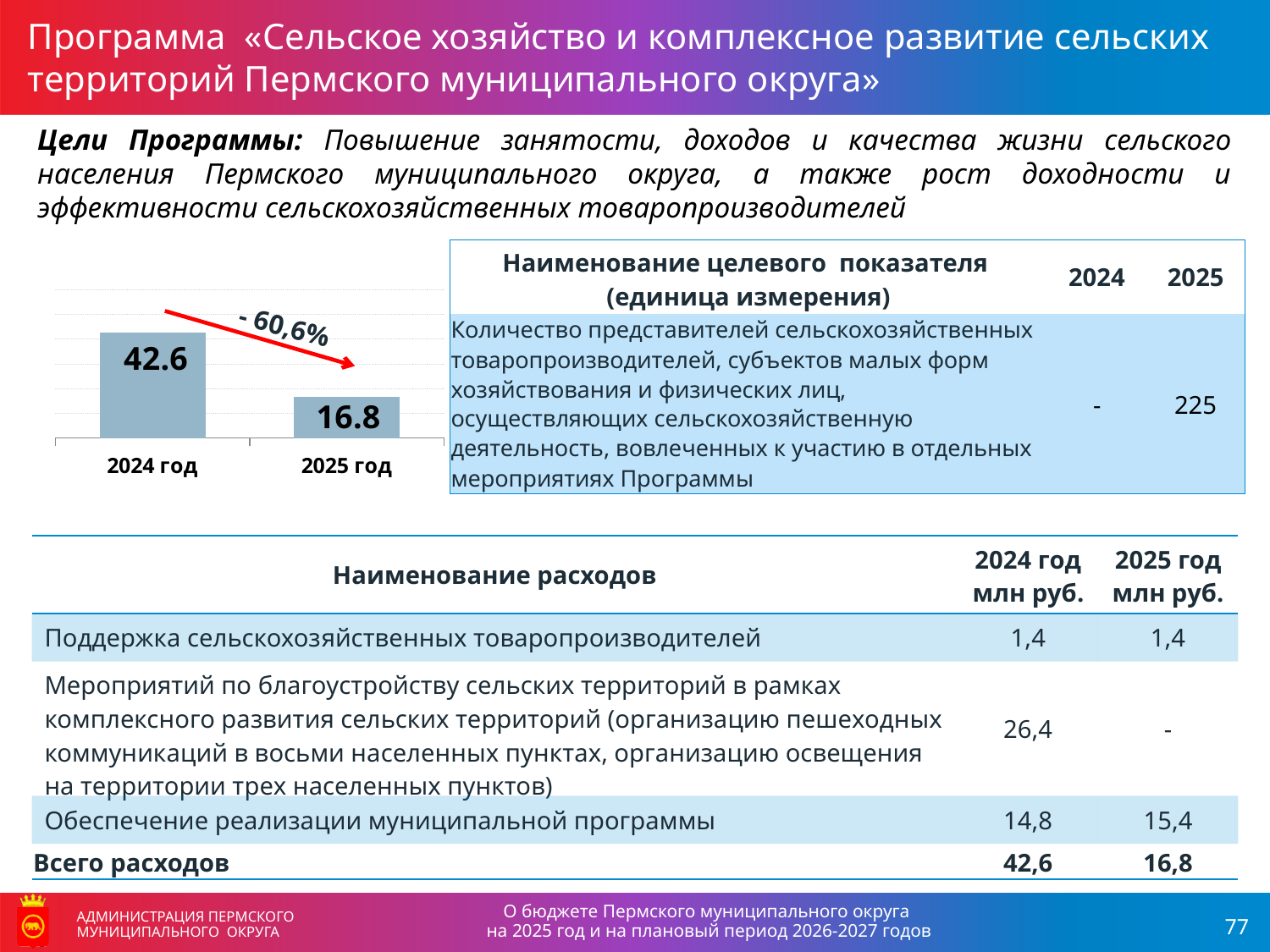
What is the value for 2025 год in the bar chart? 16.8 What percentage change is annotated on the arrow in the bar chart? - 60,6% How many bars are shown in the bar chart? 2 Do the values in the bar chart rise or fall from 2024 год to 2025 год? Fall What is the difference between the values for 2024 год and 2025 год in the bar chart? 25.8 Which year has the lowest value in the bar chart? 2025 год What kind of chart is shown on the left of the slide? Bar chart What is the value for 2024 год in the bar chart? 42.6 Which is larger in the bar chart, the value for 2024 год or for 2025 год? 2024 год What colour are the bars in the bar chart? Grey-blue Which year has the highest value in the bar chart? 2024 год